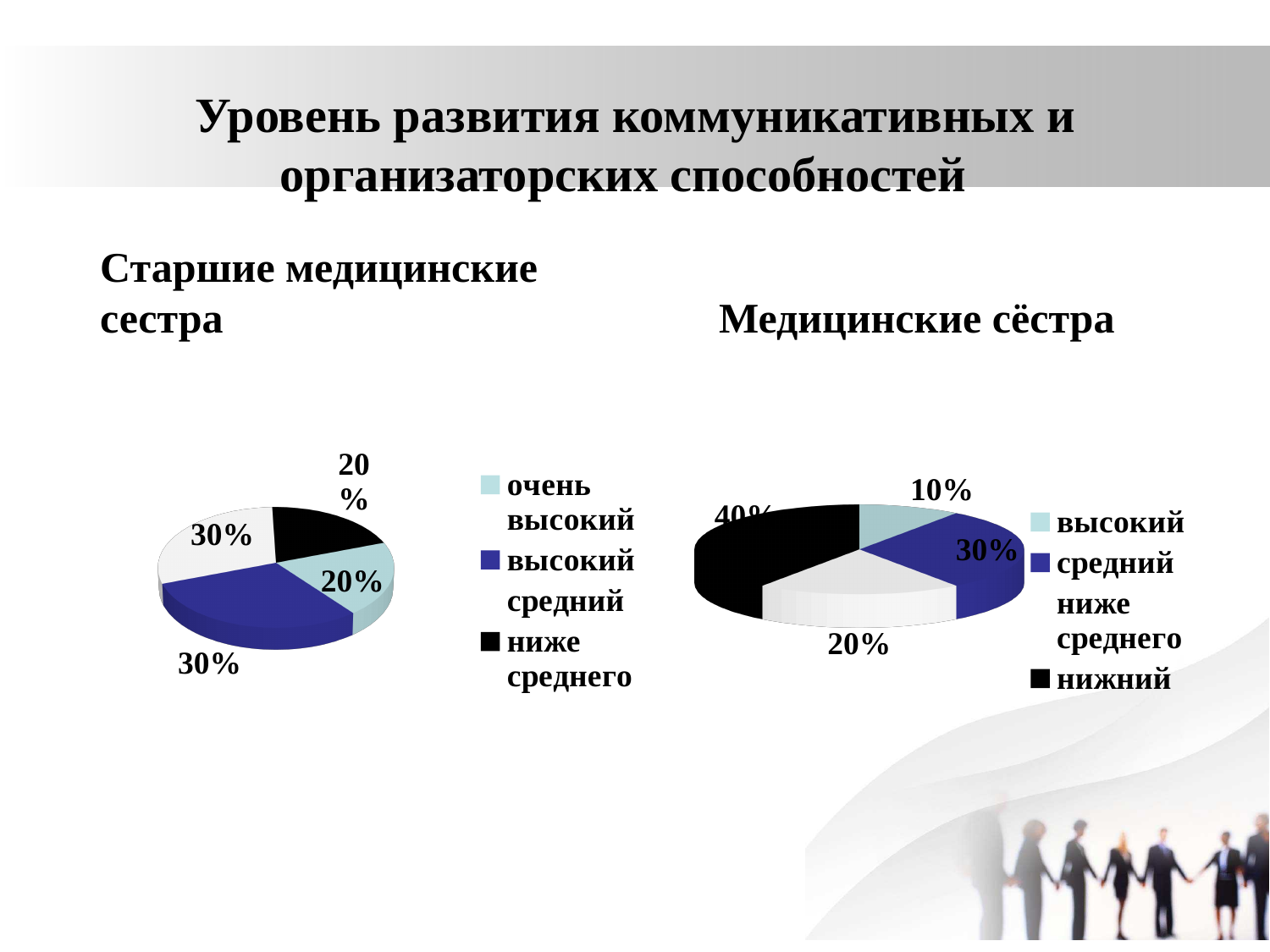
In the right pie chart (Медицинские сёстра), which is larger: the 'средний' slice or the 'ниже среднего' slice? средний In the right pie chart (Медицинские сёстра), what share is labelled for the 'нижний' slice? 40% In the left pie chart (Старшие медицинские сестра), what share is labelled for the 'ниже среднего' slice? 20% In the left pie chart (Старшие медицинские сестра), what colour is the 'ниже среднего' slice? Black In the right pie chart (Медицинские сёстра), which category has the smallest slice? высокий How many categories does the legend of the left pie chart (Старшие медицинские сестра) list? 4 In the right pie chart (Медицинские сёстра), what share is labelled for the 'высокий' slice? 10% In the left pie chart (Старшие медицинские сестра), what share is labelled for the 'очень высокий' slice? 20% In the right pie chart (Медицинские сёстра), what share is labelled for the 'средний' slice? 30% In the right pie chart (Медицинские сёстра), what is the difference between the 'нижний' and 'высокий' shares? 30% In the right pie chart (Медицинские сёстра), which category has the largest slice? нижний What type of chart is used for the 'Медицинские сёстра' data? Pie chart